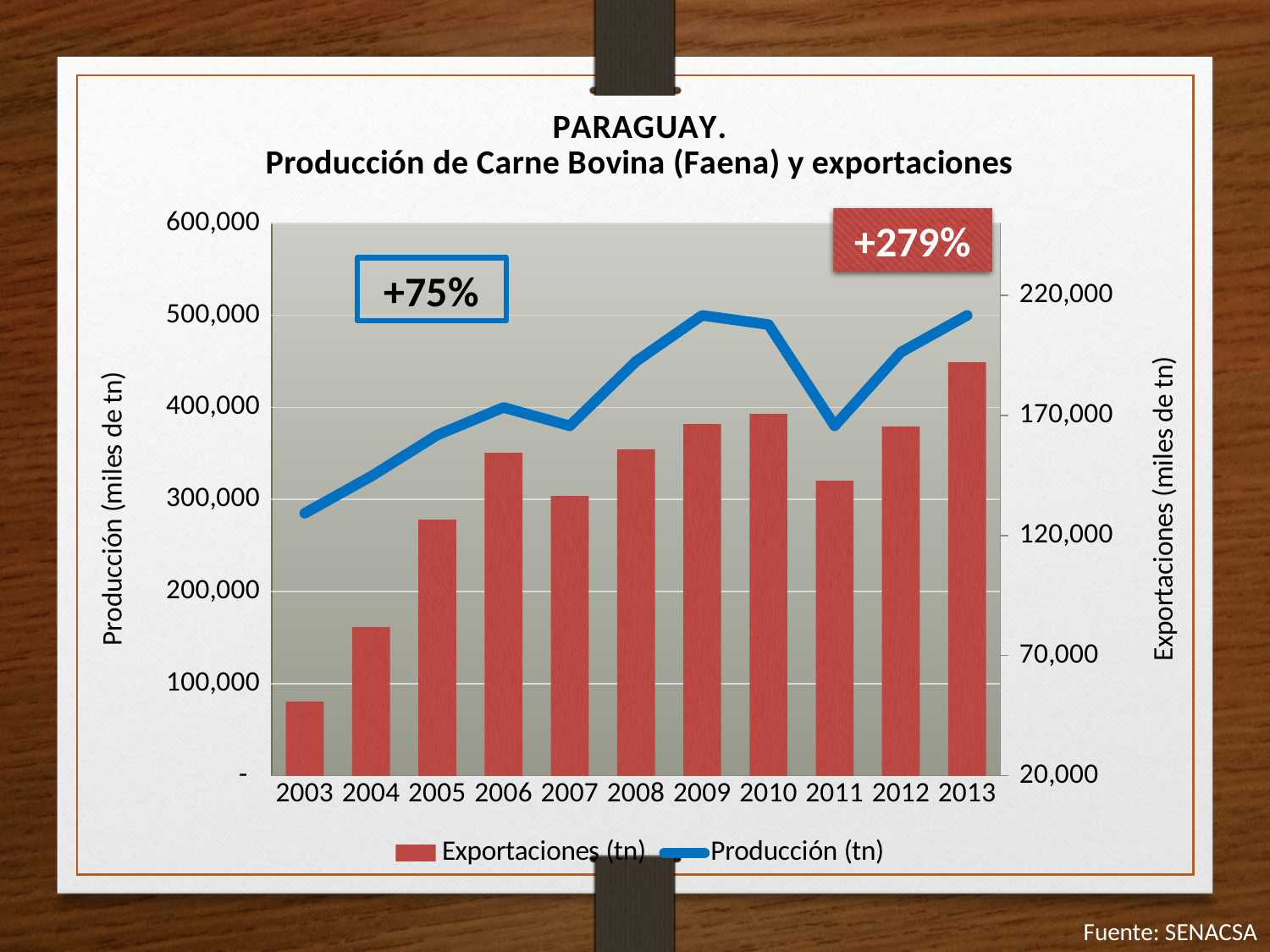
How many years are shown on the x axis? 11 What kind of chart is shown on the slide? A combined bar and line chart How many series does the legend list? 2 Which year has the highest bar for Exportaciones (tn)? 2013 In which year is the Producción (tn) line at its lowest point? 2003 What percentage change is shown in the blue-outlined box on the chart? +75% Which year has the lowest bar for Exportaciones (tn)? 2003 Which year has the larger Exportaciones (tn) value, 2004 or 2005? 2005 What percentage change is shown in the red box on the chart? +279% Which year has the larger Producción (tn) value, 2010 or 2011? 2010 Which year has the larger Exportaciones (tn) value, 2010 or 2011? 2010 Overall, do the Exportaciones (tn) bars rise or fall from 2003 to 2013? Rise